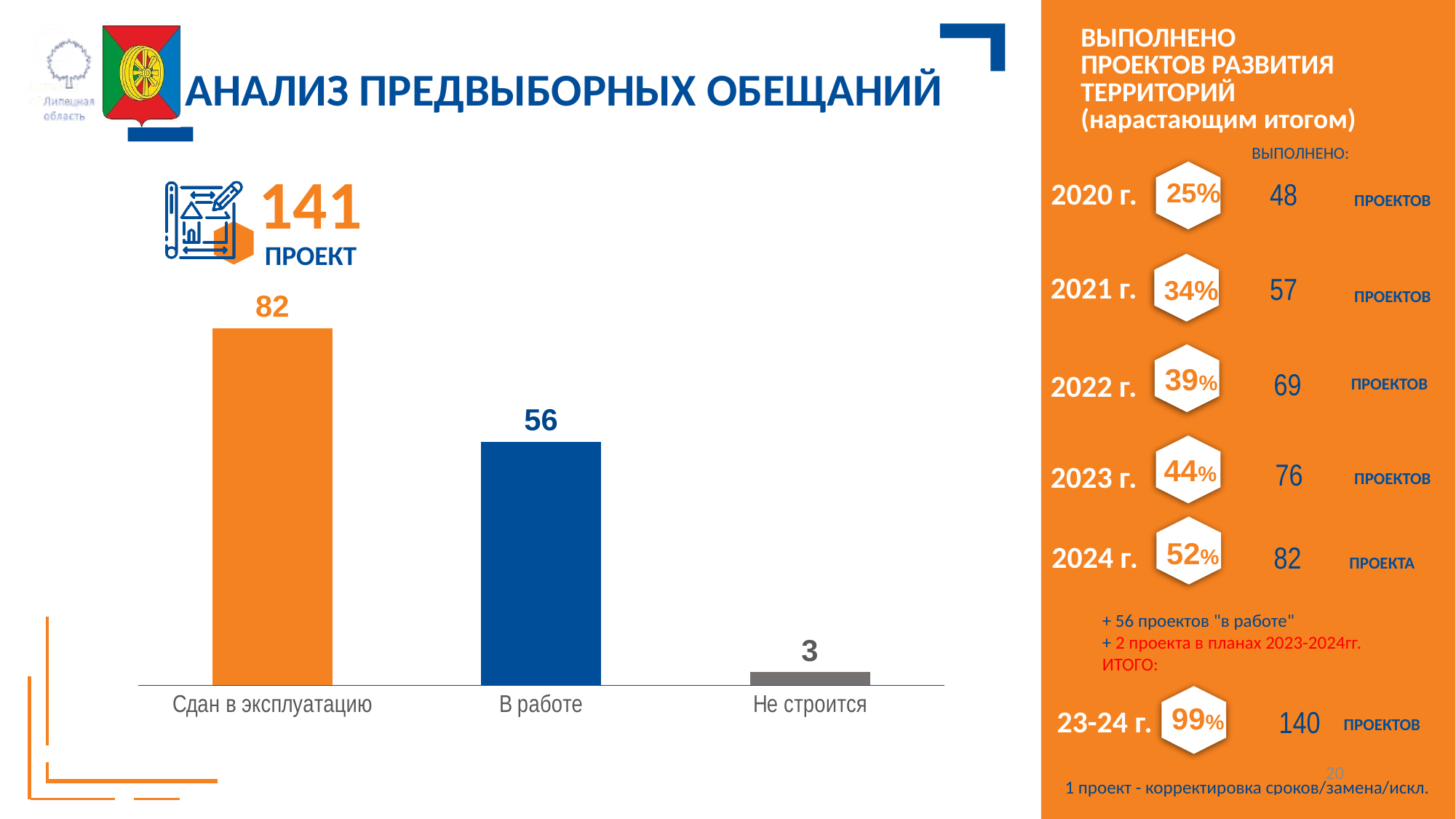
What is the value for "В работе" in the bar chart? 56 What is the value for "Не строится" in the bar chart? 3 What is the value for "Сдан в эксплуатацию" in the bar chart? 82 What kind of chart is shown on the slide? Bar chart How many categories are shown in the bar chart? 3 What is the difference between the values for "Сдан в эксплуатацию" and "В работе"? 26 What colour is the bar for "В работе"? Blue Which category has the lowest value in the bar chart? Не строится Which is larger, the value for "Сдан в эксплуатацию" or the value for "В работе"? Сдан в эксплуатацию Do the bar values rise or fall from left to right across the categories? Fall What is the difference between the values for "В работе" and "Не строится"? 53 Which category has the highest value in the bar chart? Сдан в эксплуатацию